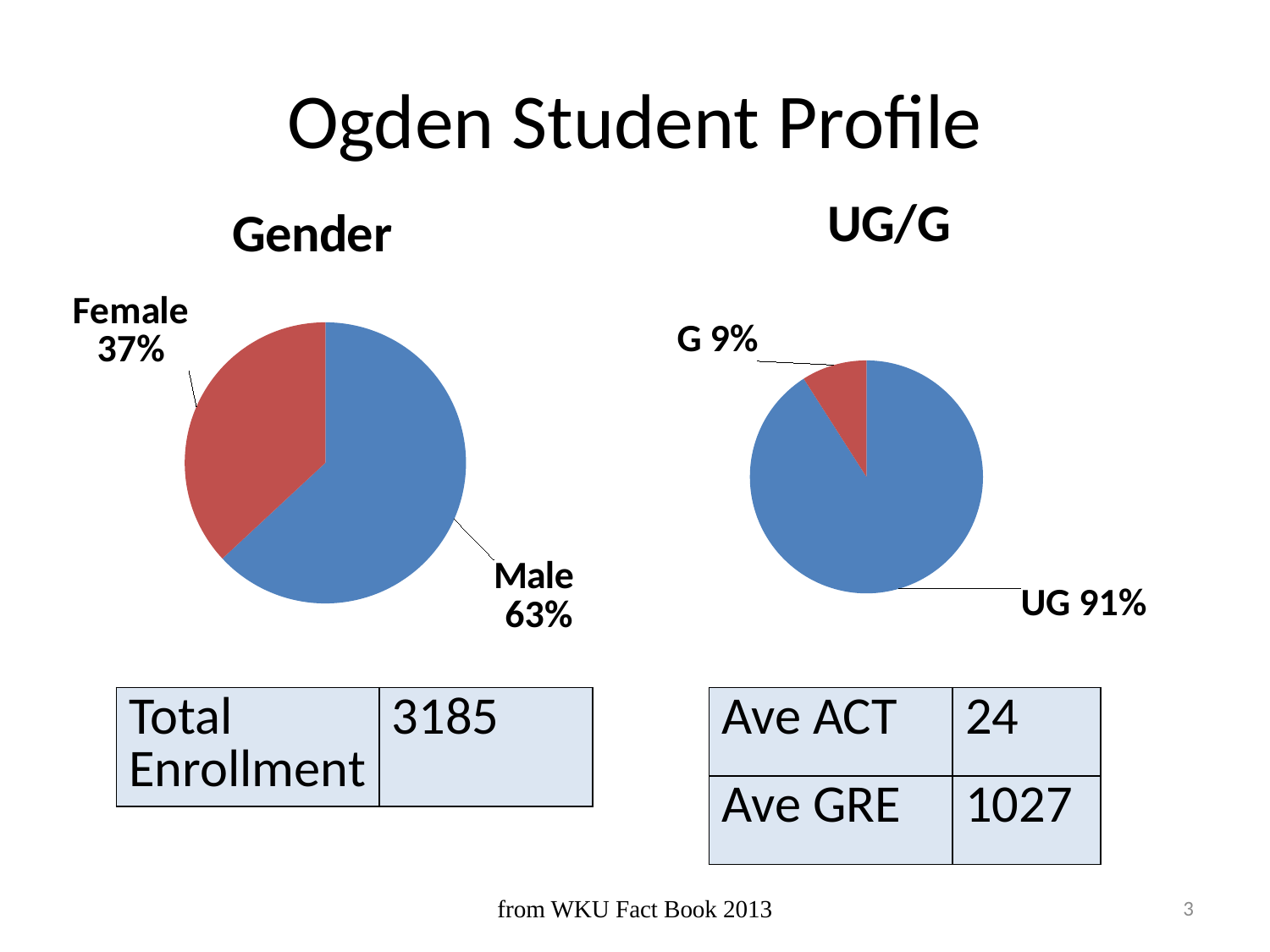
How many slices does the UG/G pie chart have? 2 In the UG/G pie chart, what is the difference between the UG and G shares? 82% In the UG/G pie chart, what share of students is G? 9% In the Gender pie chart, what is the difference between the Male and Female shares? 26% In the UG/G pie chart, which category has the smaller share? G In the UG/G pie chart, what share of students is UG? 91% In the Gender pie chart, what colour is the Female slice? Red What is the title of the pie chart on the right of the slide? UG/G What kind of chart is the Gender chart? Pie chart In the Gender pie chart, what share of students is Female? 37% In the Gender pie chart, which category has the larger share? Male